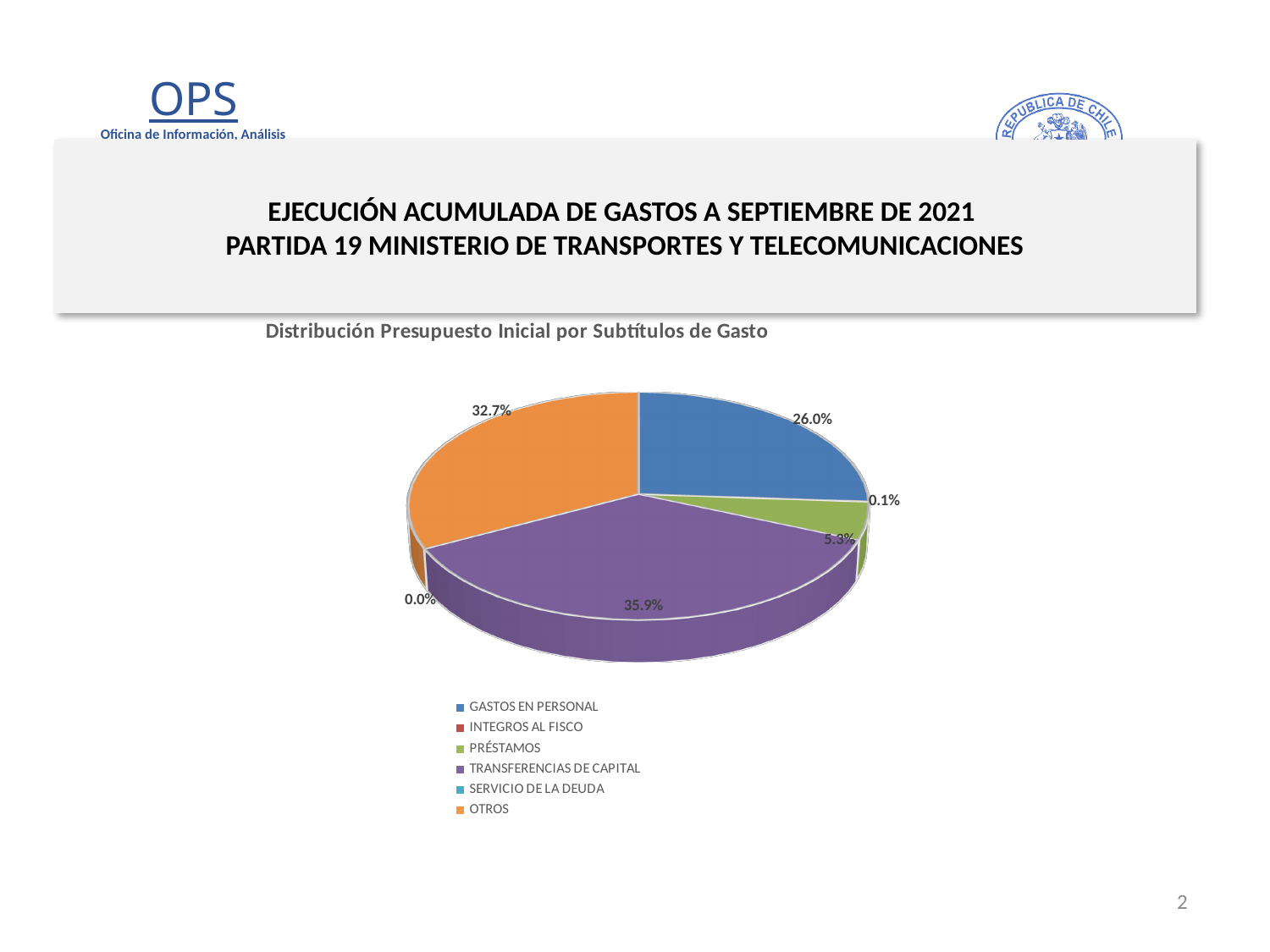
Which is larger, the share for GASTOS EN PERSONAL or the share for PRÉSTAMOS? GASTOS EN PERSONAL What is the title of the chart? Distribución Presupuesto Inicial por Subtítulos de Gasto What kind of chart is shown on the slide? Pie chart What share of the pie does TRANSFERENCIAS DE CAPITAL represent? 35.9% How many categories does the legend of the pie chart list? 6 What share of the pie does OTROS represent? 32.7% Which category has the largest share of the pie? TRANSFERENCIAS DE CAPITAL What share of the pie does PRÉSTAMOS represent? 5.3% What share of the pie does GASTOS EN PERSONAL represent? 26.0% Which category has the smallest share of the pie? SERVICIO DE LA DEUDA What is the difference in percentage points between TRANSFERENCIAS DE CAPITAL and OTROS? 3.2 What colour is the slice for OTROS? Orange